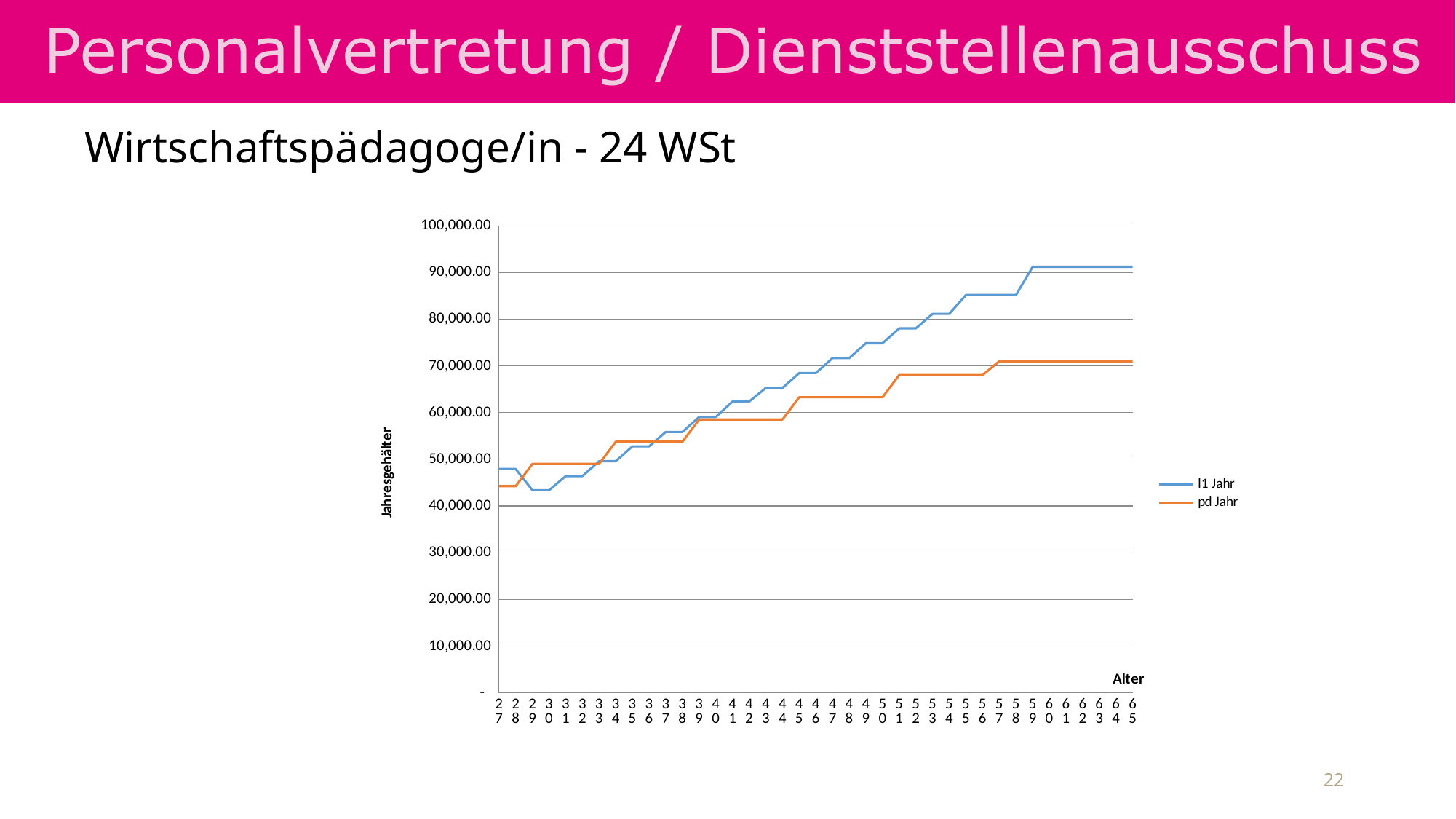
What kind of chart is shown on the slide? line chart How many series does the chart legend list? 2 How many age values are plotted along the x axis (from 27 to 65)? 39 Do the values of l1 Jahr generally rise or fall as age increases from 27 to 65? rise What are the names of the two series in the legend? l1 Jahr and pd Jahr Is the value of l1 Jahr at age 27 greater or less than 50,000.00? less What is the label of the vertical axis? Jahresgehälter At age 34, which series has the higher value, l1 Jahr or pd Jahr? pd Jahr Is the value of pd Jahr at age 65 greater or less than 80,000.00? less At age 65, which series has the higher value, l1 Jahr or pd Jahr? l1 Jahr Is the value of pd Jahr at age 50 greater or less than 60,000.00? greater